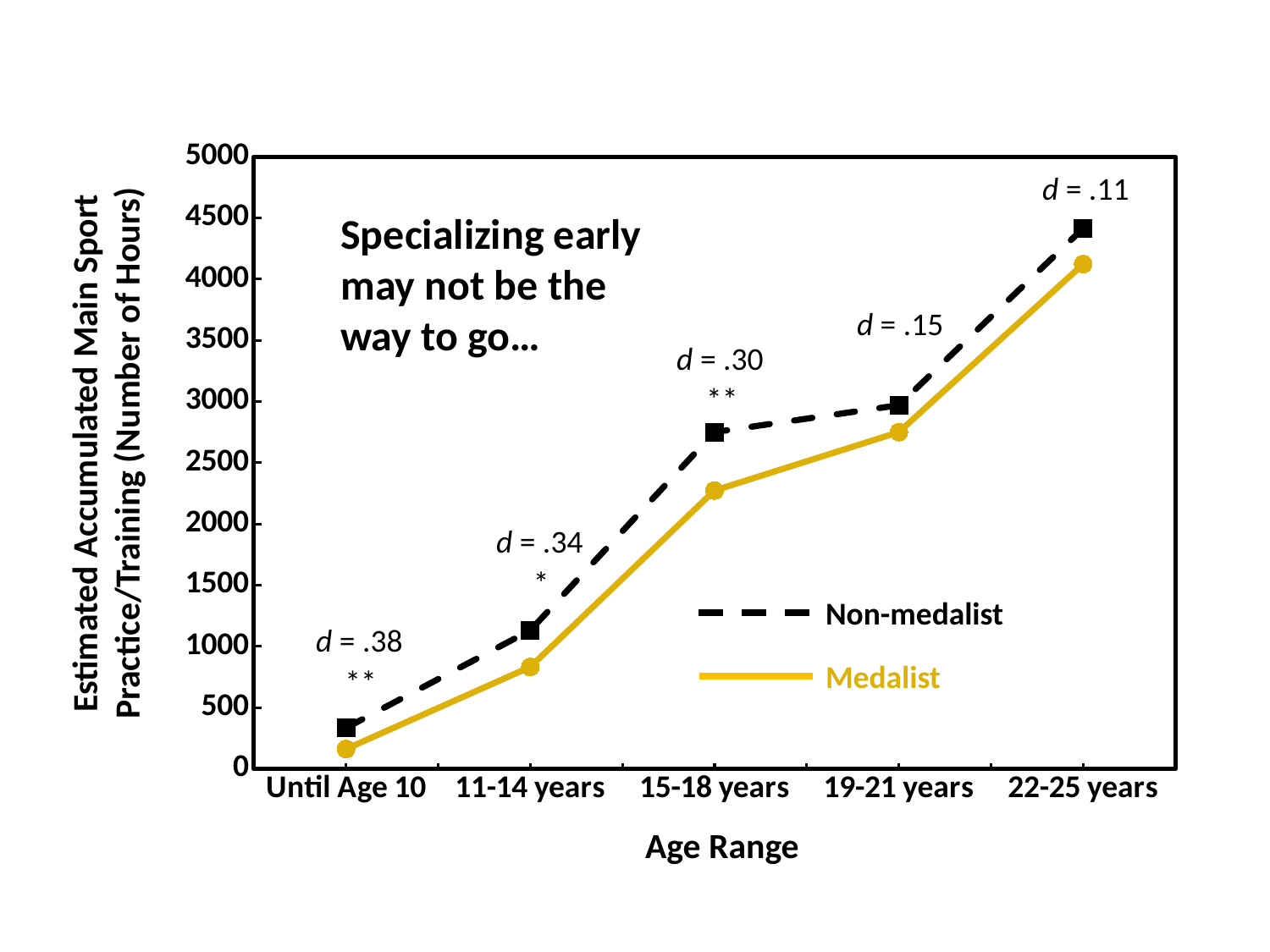
How many series does the legend list? 2 How many age-range categories are shown on the x axis? 5 Is the Medalist value for 15-18 years greater or less than 2500? less Do the Medalist values rise or fall as age range increases along the x axis? rise Is the Non-medalist value for 22-25 years greater or less than 4000? greater What kind of chart is shown on the slide? line chart For which age range is the Medalist value lowest? Until Age 10 Is the Medalist value for 11-14 years greater or less than 1000? less What d value is annotated above the 15-18 years points? d = .30 For which age range is the Non-medalist value highest? 22-25 years What is the title of the x axis? Age Range At 15-18 years, which series has the larger value, Non-medalist or Medalist? Non-medalist